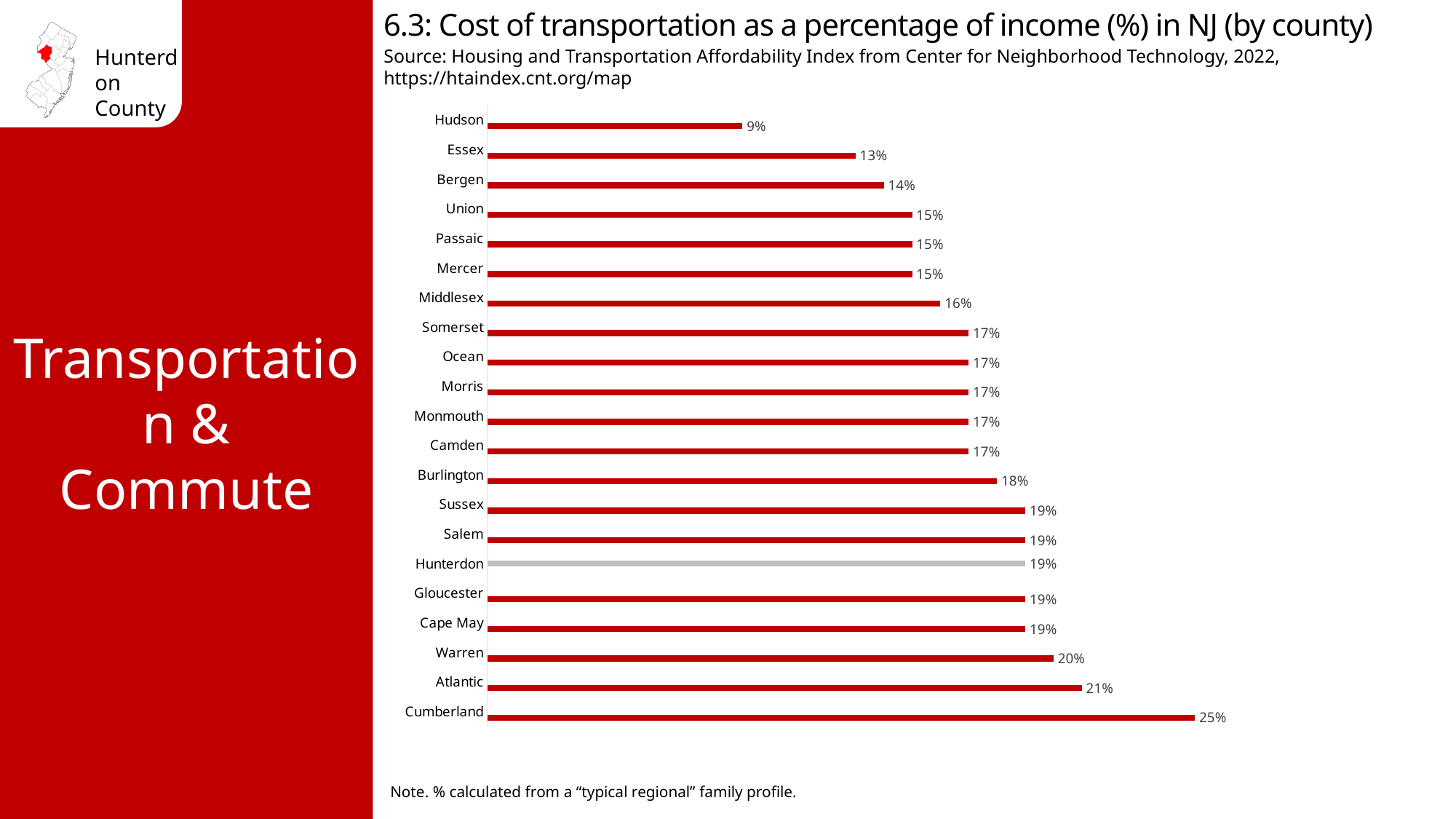
What is the difference between the values for Atlantic and Warren? 1% Which has a higher value, Essex or Burlington? Burlington Which county's bar is shown in grey rather than red? Hunterdon Which has a higher value, Bergen or Atlantic? Atlantic How many counties are shown in the chart? 21 Which county has the lowest cost of transportation as a percentage of income? Hudson What is the value shown for Middlesex County? 16% What kind of chart is shown on the slide? Bar chart What is the cost of transportation as a percentage of income for Hunterdon County? 19% Which county has the highest cost of transportation as a percentage of income? Cumberland What is the cost of transportation as a percentage of income for Hudson County? 9% What is the difference between the values for Cumberland and Hudson? 16%